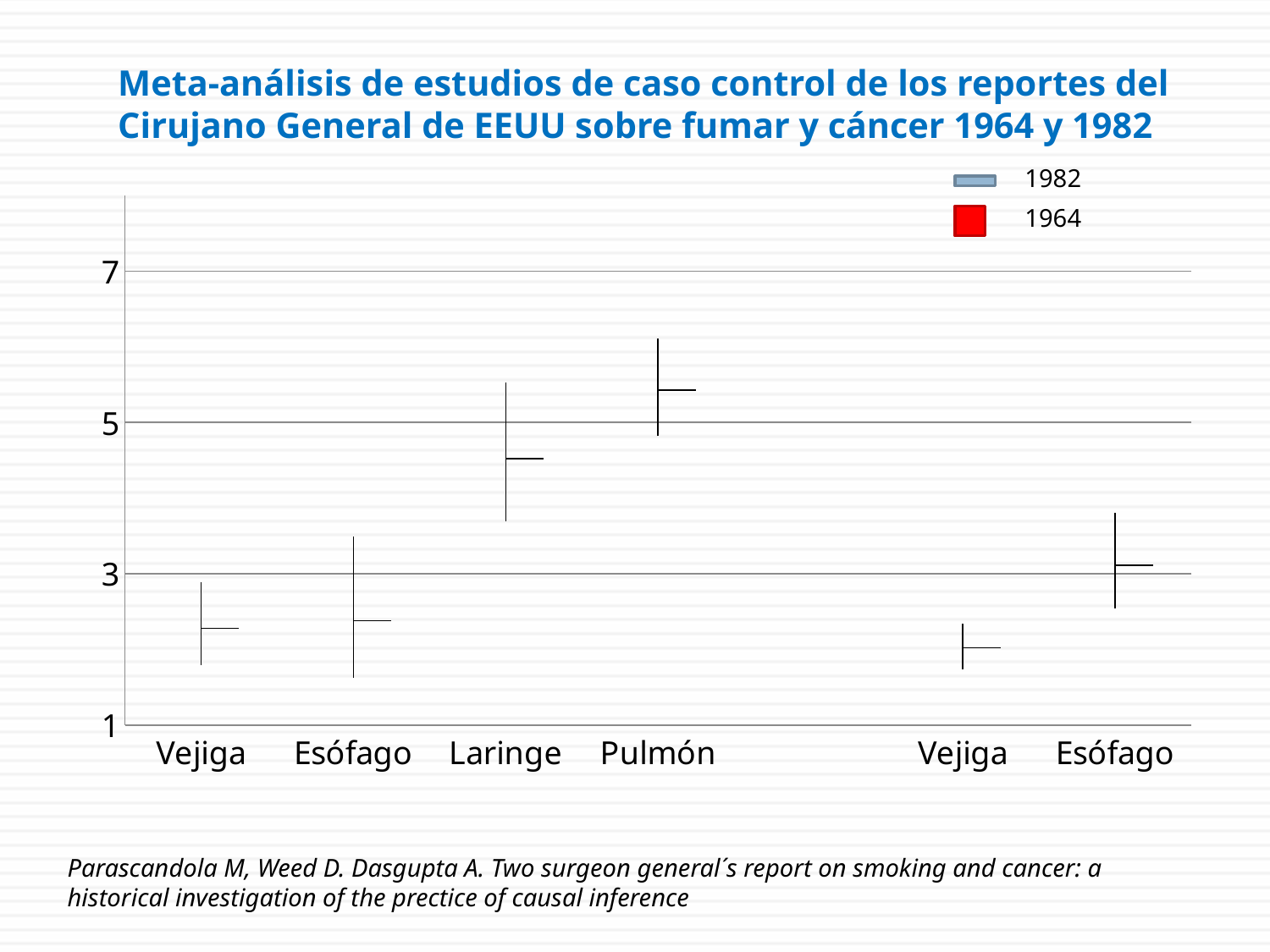
Which has the larger central value, Pulmón or Laringe? Pulmón Is the central value for the left-hand Vejiga category greater or less than 3? less Is the central value for the right-hand Esófago category greater or less than 3? greater Which has the larger central value, Laringe or the left-hand Esófago? Laringe How many category labels are shown along the x axis? 6 Is the central value for Laringe greater or less than 5? less What are the two entries in the chart legend? 1982 and 1964 How many series does the legend list? 2 Which category has the highest central value on the chart? Pulmón